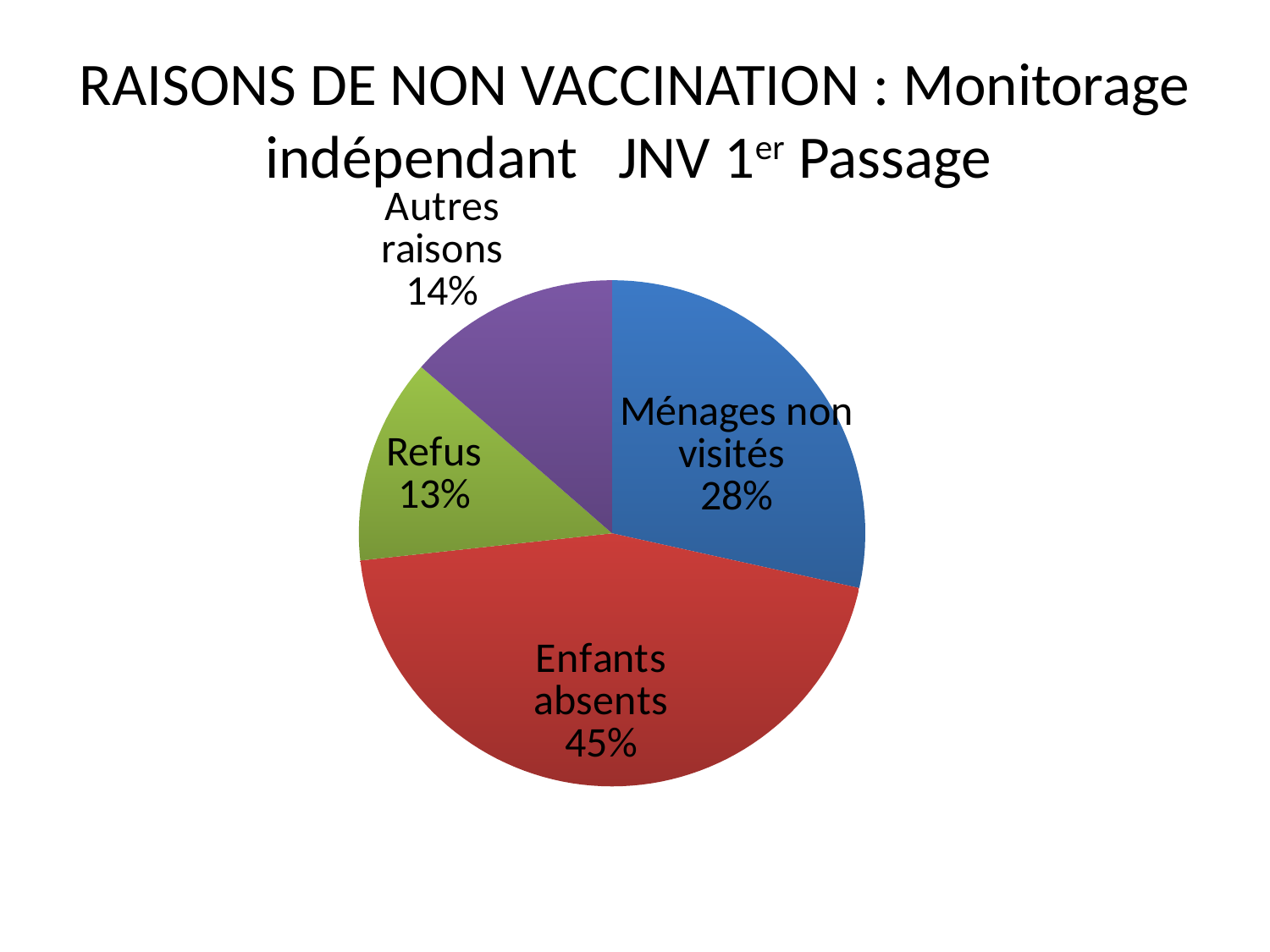
Which category has the largest slice of the pie? Enfants absents What is the difference in percentage points between "Enfants absents" and "Ménages non visités"? 17 How many slices does the pie chart have? 4 What share of the pie is labelled "Refus"? 13% What colour is the slice for "Enfants absents"? Red What share of the pie is labelled "Autres raisons"? 14% What is the combined share of "Refus" and "Autres raisons"? 27% What share of the pie is labelled "Ménages non visités"? 28% Which is larger, the share for "Ménages non visités" or the share for "Autres raisons"? Ménages non visités Which category has the smallest slice of the pie? Refus What kind of chart is shown on the slide? Pie chart